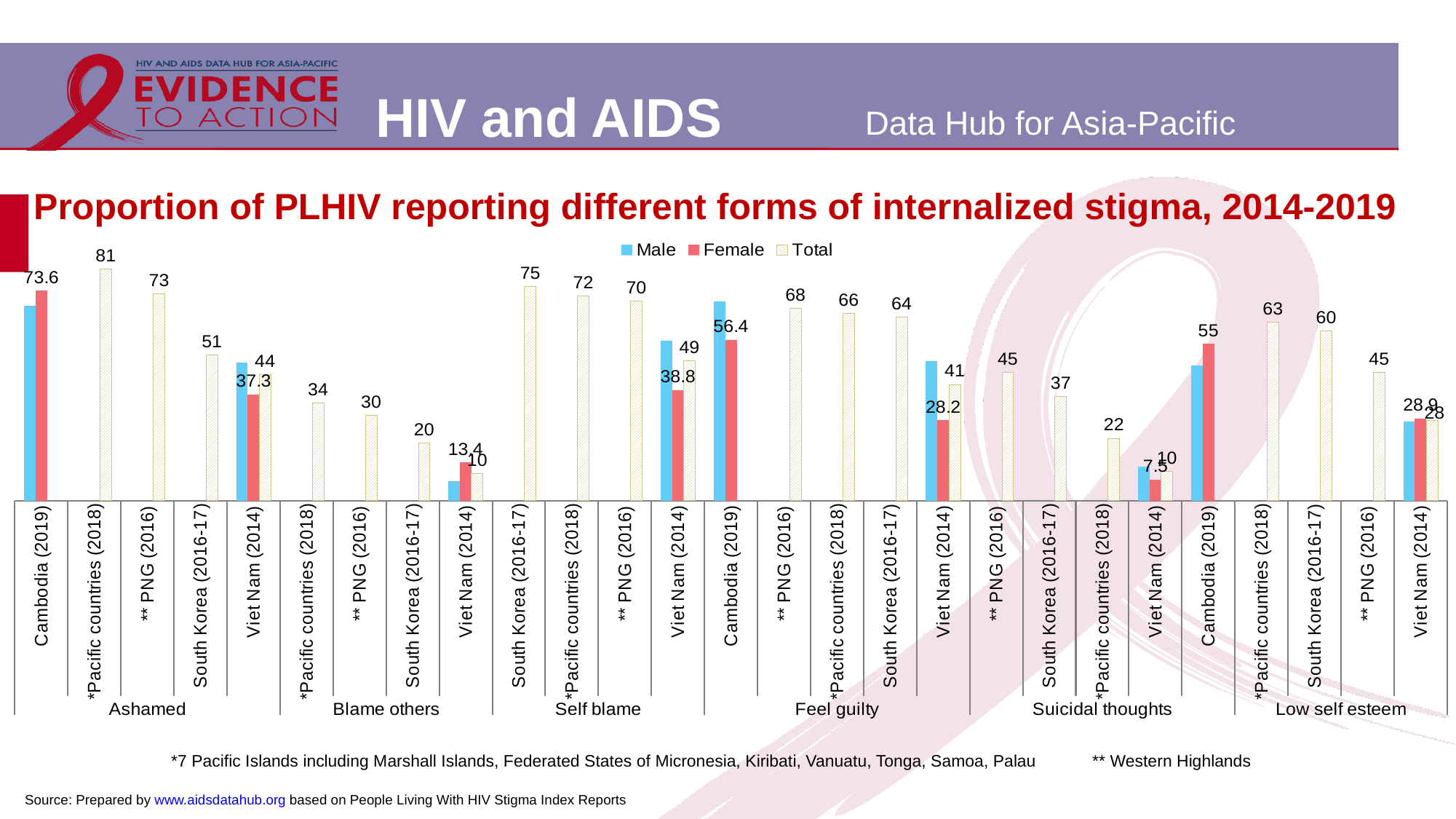
How many forms of internalized stigma are shown as groups along the x axis? 6 In the Blame others group, which country has the lowest Total value? Viet Nam (2014) How many series does the legend list? 3 What is the difference between the Total values for ** PNG (2016) and Viet Nam (2014) in the Feel guilty group? 27 In the Ashamed group, which country has the highest Total value? *Pacific countries (2018) What is the Total value for South Korea (2016-17) in the Suicidal thoughts group? 37 What value is printed above the Cambodia (2019) bars in the Suicidal thoughts group? 55 What is the Total value for *Pacific countries (2018) in the Ashamed group? 81 What is the Total value for South Korea (2016-17) in the Self blame group? 75 In the Low self esteem group, which has the larger Total value: *Pacific countries (2018) or South Korea (2016-17)? *Pacific countries (2018) What kind of chart is shown on the slide? bar chart What is the title of the chart? Proportion of PLHIV reporting different forms of internalized stigma, 2014-2019